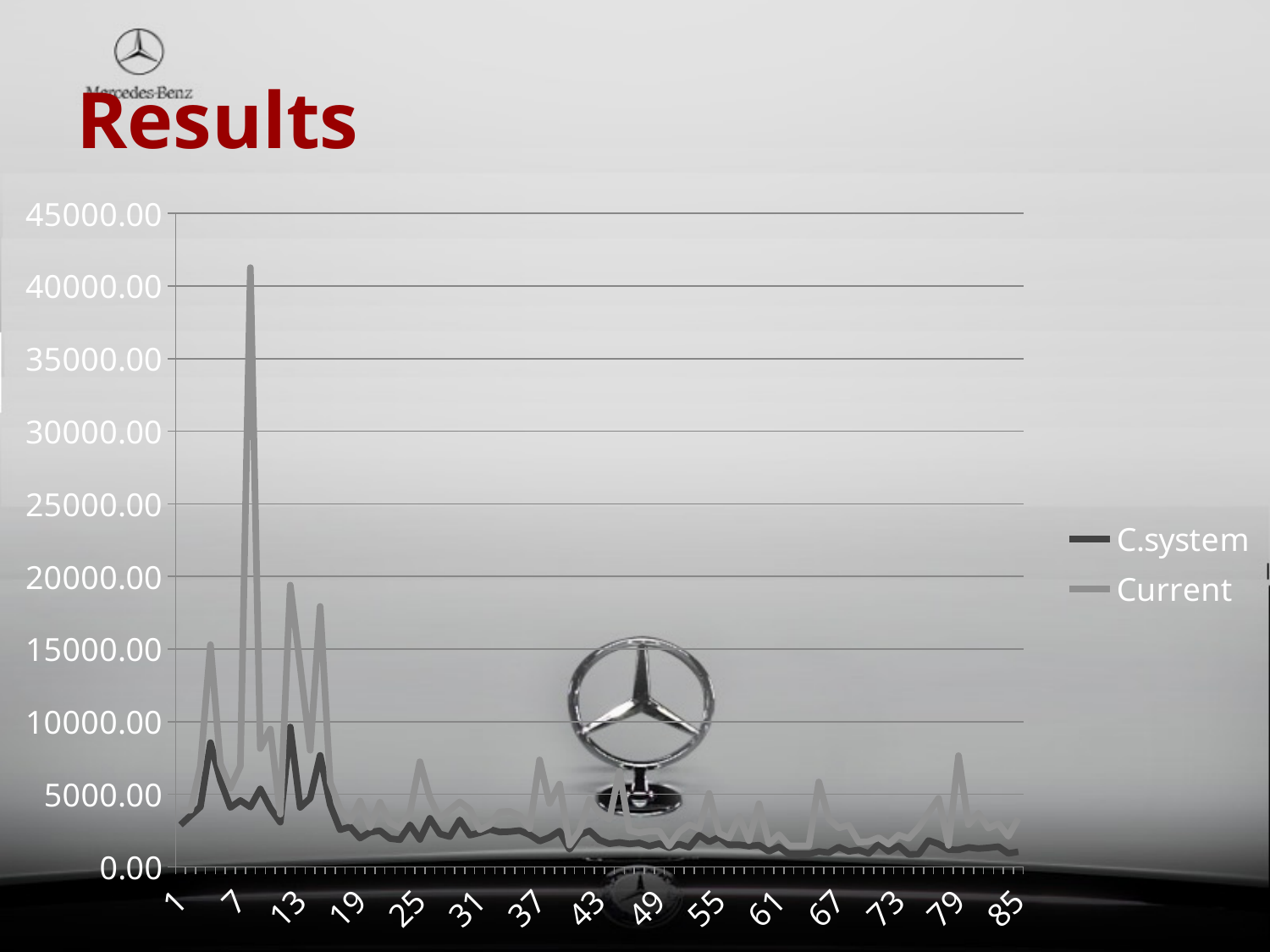
Is the highest value of the Current series greater or less than 40000.00? greater Is the value of the Current series at category 85 greater or less than 10000.00? less Is the highest value of the C.system series greater or less than 15000.00? less What are the names of the two series in the legend? C.system and Current Which series reaches the highest peak value, C.system or Current? Current How many series does the legend list? 2 Which series is generally lower across the x axis, C.system or Current? C.system What kind of chart is shown on the slide? line chart Do the values of the Current series generally rise or fall along the x axis after the early peaks? fall What is the maximum value shown on the y axis? 45000.00 What is the title of the slide containing the chart? Results